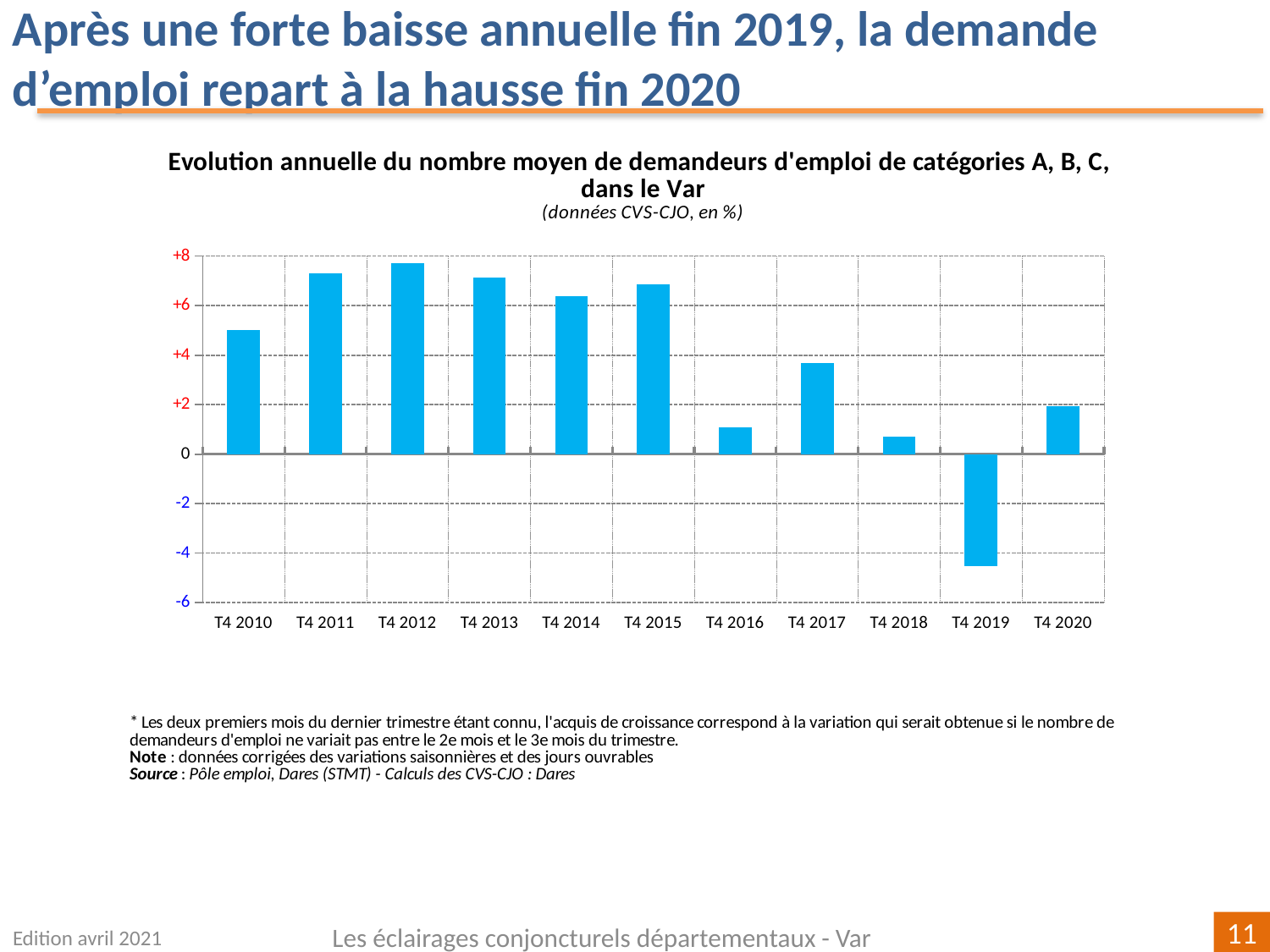
How many quarters (categories) are plotted on the x axis? 11 What kind of chart is shown on the slide? bar chart Is the value for T4 2017 greater or less than +2? greater Is the value for T4 2016 greater or less than +2? less Which is larger, the value for T4 2018 or the value for T4 2019? T4 2018 Which is larger, the value for T4 2010 or the value for T4 2017? T4 2010 Which quarter has the lowest value? T4 2019 Is the value for T4 2019 greater or less than -4? less How many quarters show a negative value? 1 Which quarter has the highest value? T4 2012 According to the chart subtitle, in what unit are the data expressed? en %